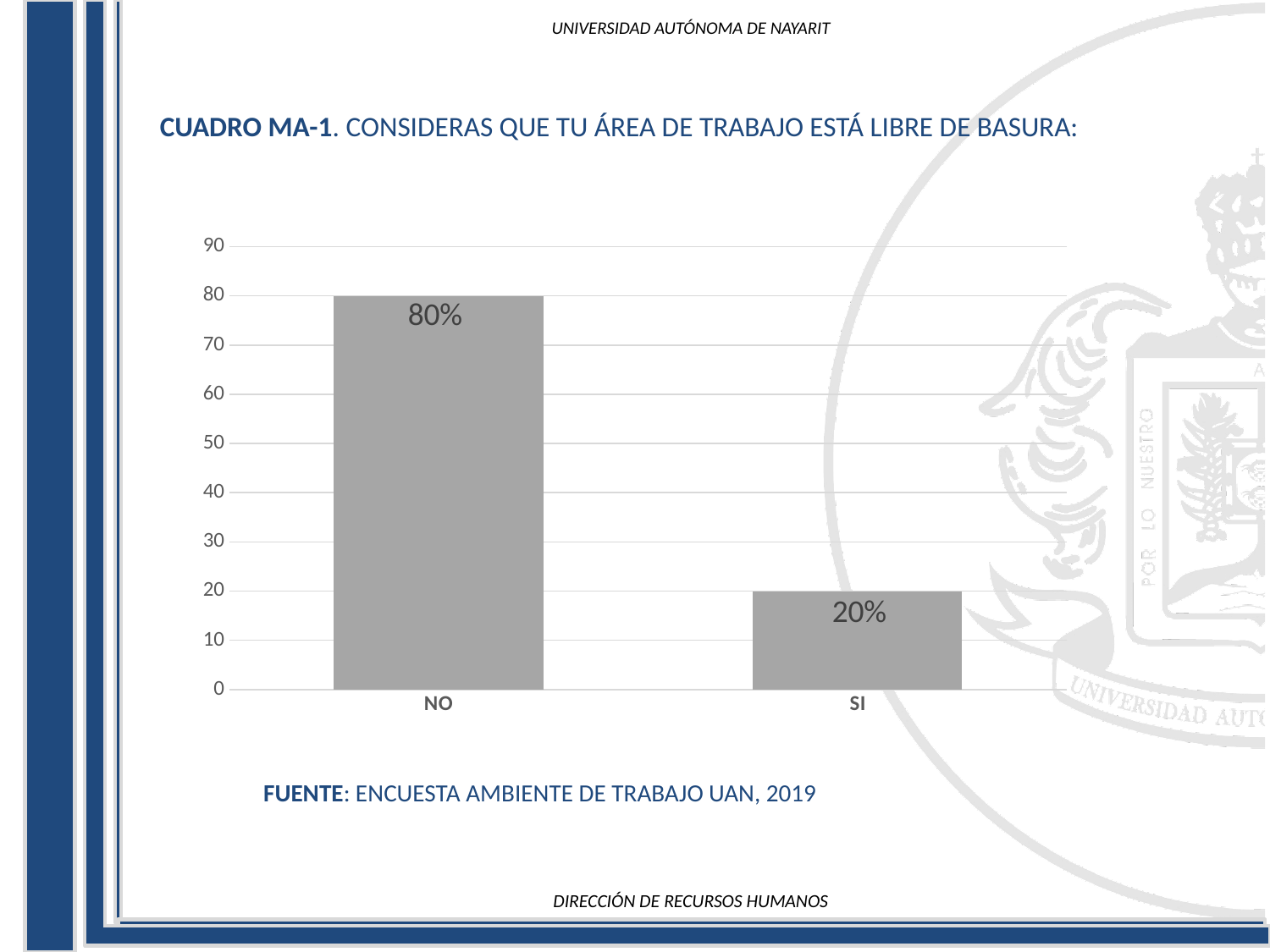
Which category has the highest value? NO What is the difference between the values for NO and SI? 60% How many categories are shown on the x axis? 2 What is the value for NO? 80% Is the value for NO greater or less than 50? greater Is the value for SI greater or less than 30? less Which is larger, the value for NO or the value for SI? NO What is the source cited below the chart? ENCUESTA AMBIENTE DE TRABAJO UAN, 2019 What is the value for SI? 20% What kind of chart is shown on the slide? bar chart What is the highest value shown on the vertical axis? 90 Which category has the lowest value? SI